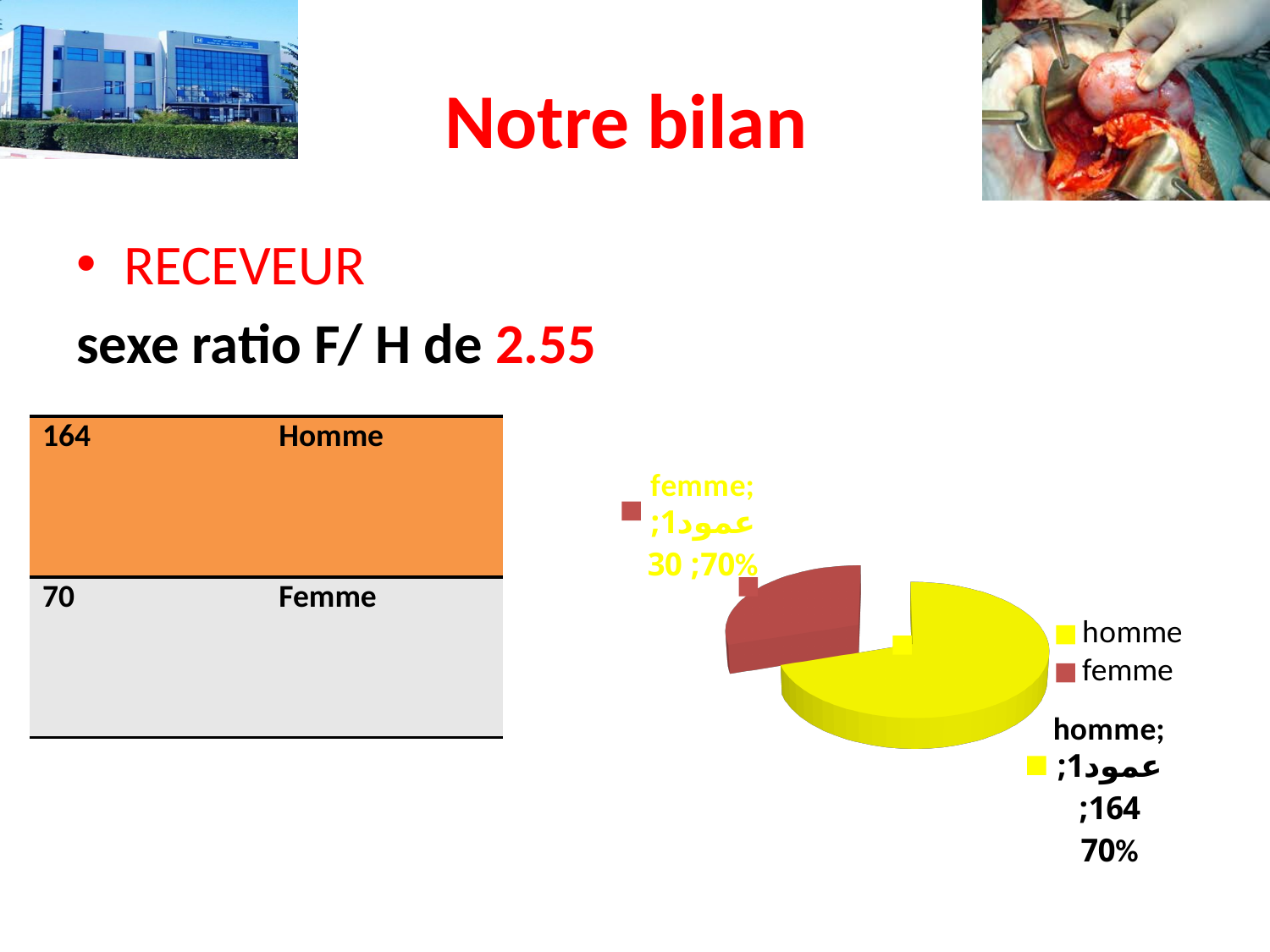
What colour is the homme slice in the pie chart? yellow How many slices does the pie chart have? 2 How many entries does the pie chart's legend list? 2 What percentage share is labelled on the homme slice of the pie chart? 70% What are the two legend entries of the pie chart? homme and femme Which slice of the pie chart is the smallest? femme Which slice of the pie chart is the largest? homme In the pie chart, which slice is larger, homme or femme? homme What value is labelled on the homme slice of the pie chart? 164 What kind of chart is shown on the slide? pie chart